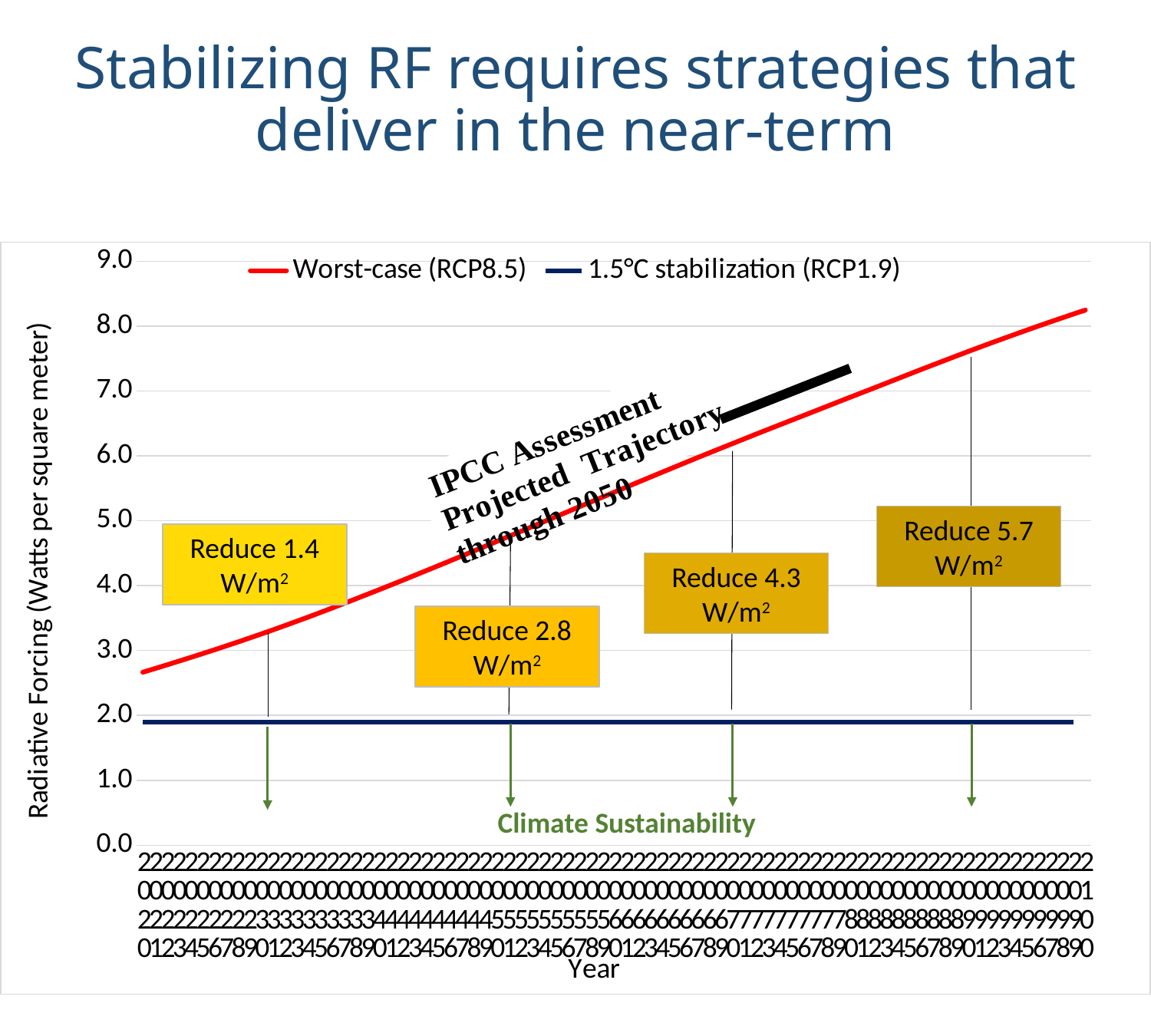
Does the Worst-case (RCP8.5) line rise or fall as the years increase? rise What kind of chart is shown on the slide? line chart Which series has the higher values across the chart, Worst-case (RCP8.5) or 1.5°C stabilization (RCP1.9)? Worst-case (RCP8.5) How many series does the legend list? 2 What is the y-axis label of the chart? Radiative Forcing (Watts per square meter) Is the 1.5°C stabilization (RCP1.9) line greater or less than 3.0 throughout the chart? less What is the smallest reduction value shown in the annotation boxes? 1.4 W/m² Is the Worst-case (RCP8.5) value at the left end of the chart (2020) greater or less than 3.0? less How many 'Reduce' annotation boxes are shown on the chart? 4 Is the Worst-case (RCP8.5) value at the right end of the chart (2100) greater or less than 8.0? greater What are the two series named in the legend? Worst-case (RCP8.5) and 1.5°C stabilization (RCP1.9) What is the largest reduction value shown in the annotation boxes? 5.7 W/m²